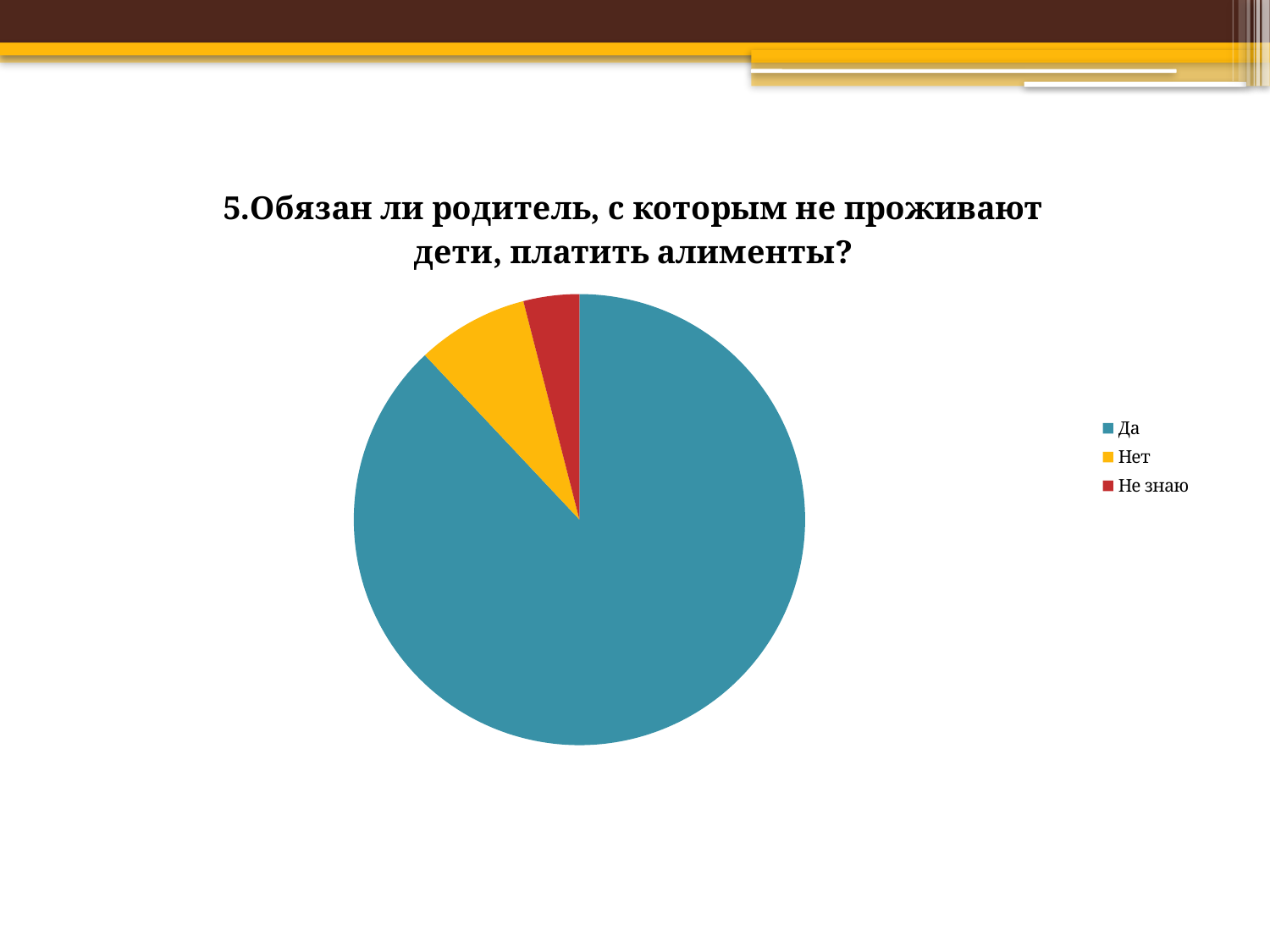
Which slice is larger, Да or Нет? Да What is the title of the chart? 5.Обязан ли родитель, с которым не проживают дети, платить алименты? How many entries does the legend list? 3 Which category has the smallest slice of the pie? Не знаю How many slices does the pie chart have? 3 Which slice is larger, Нет or Не знаю? Нет Which category has the largest slice of the pie? Да What kind of chart is shown on the slide? pie chart What colour is the slice for Не знаю? red